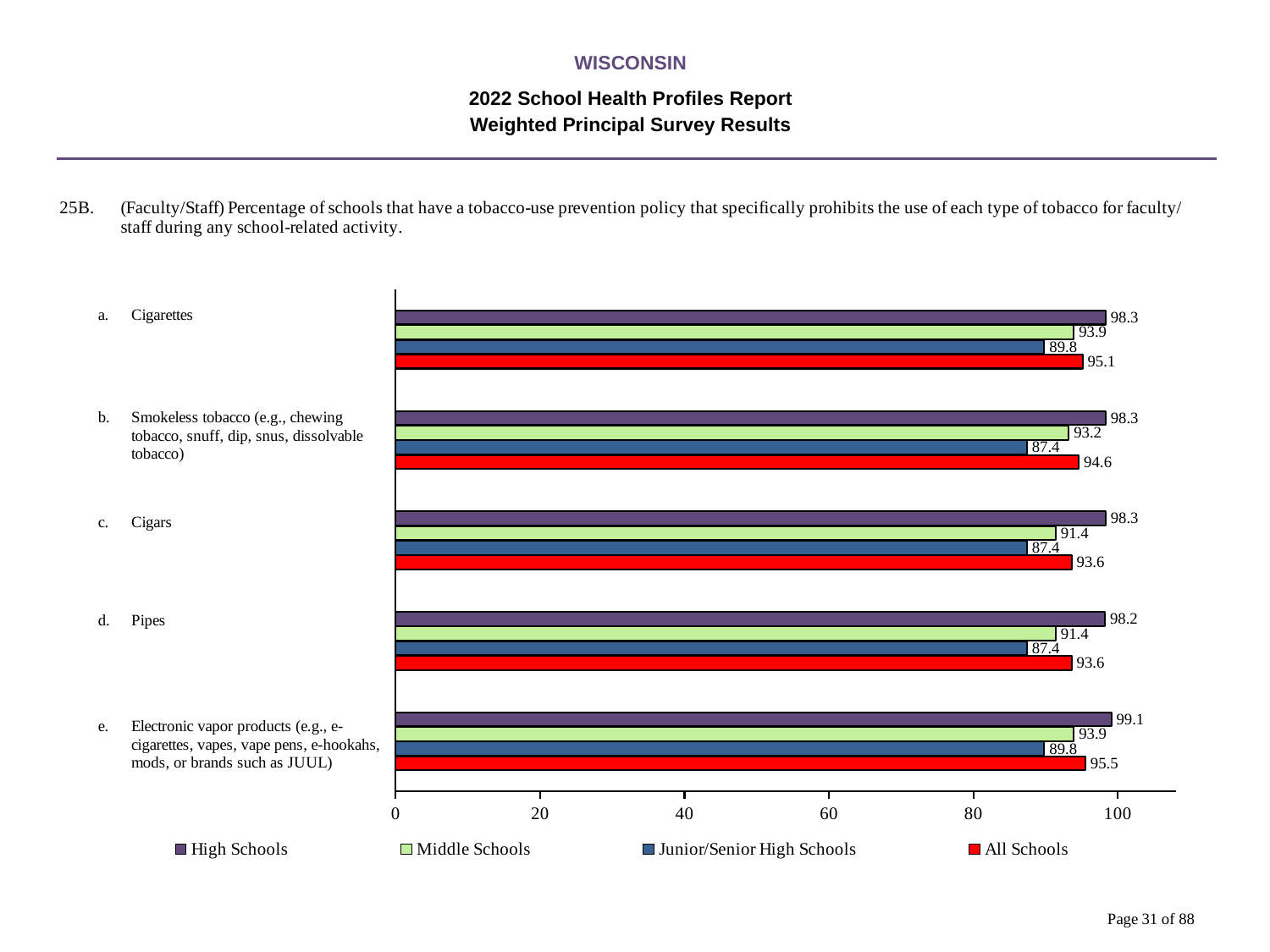
What is the value for All Schools for Electronic vapor products? 95.5 What kind of chart is shown on the slide? bar chart How many tobacco categories are shown on the chart? 5 Is the value for Junior/Senior High Schools for Cigarettes greater or less than 80? greater How many series does the legend list? 4 Which is larger for Cigarettes: the Middle Schools value or the All Schools value? All Schools What is the difference between the High Schools and Junior/Senior High Schools values for Pipes? 10.8 Which category has the lowest value for All Schools? Cigars and Pipes (93.6) Which category has the highest value for High Schools? Electronic vapor products What is the value for Middle Schools for Cigars? 91.4 What is the value for High Schools for Cigarettes? 98.3 What is the value for Junior/Senior High Schools for Smokeless tobacco? 87.4